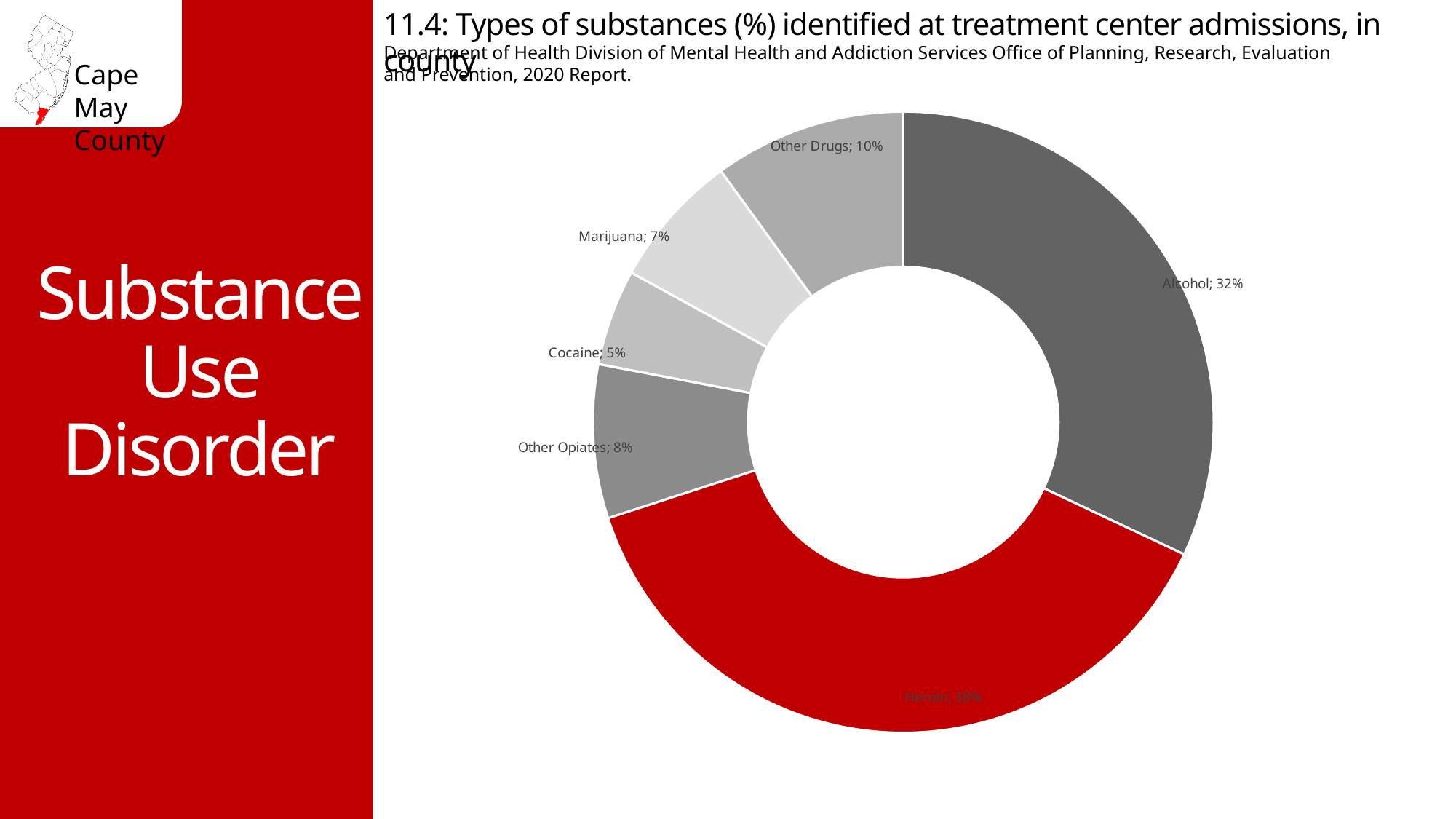
What percentage is shown for Other Opiates? 8% What percentage is shown for Other Drugs? 10% What percentage is shown for Marijuana? 7% How many percentage points higher is Alcohol than Other Drugs? 22 Which substance has the largest share of admissions? Heroin What percentage is shown for Cocaine? 5% What percentage of treatment center admissions is attributed to Alcohol? 32% How many substance categories are shown in the chart? 6 What percentage is shown for Heroin? 38% Which substance has the smallest share of admissions? Cocaine What kind of chart is used on this slide? Pie (doughnut) chart Which has a larger share, Marijuana or Cocaine? Marijuana